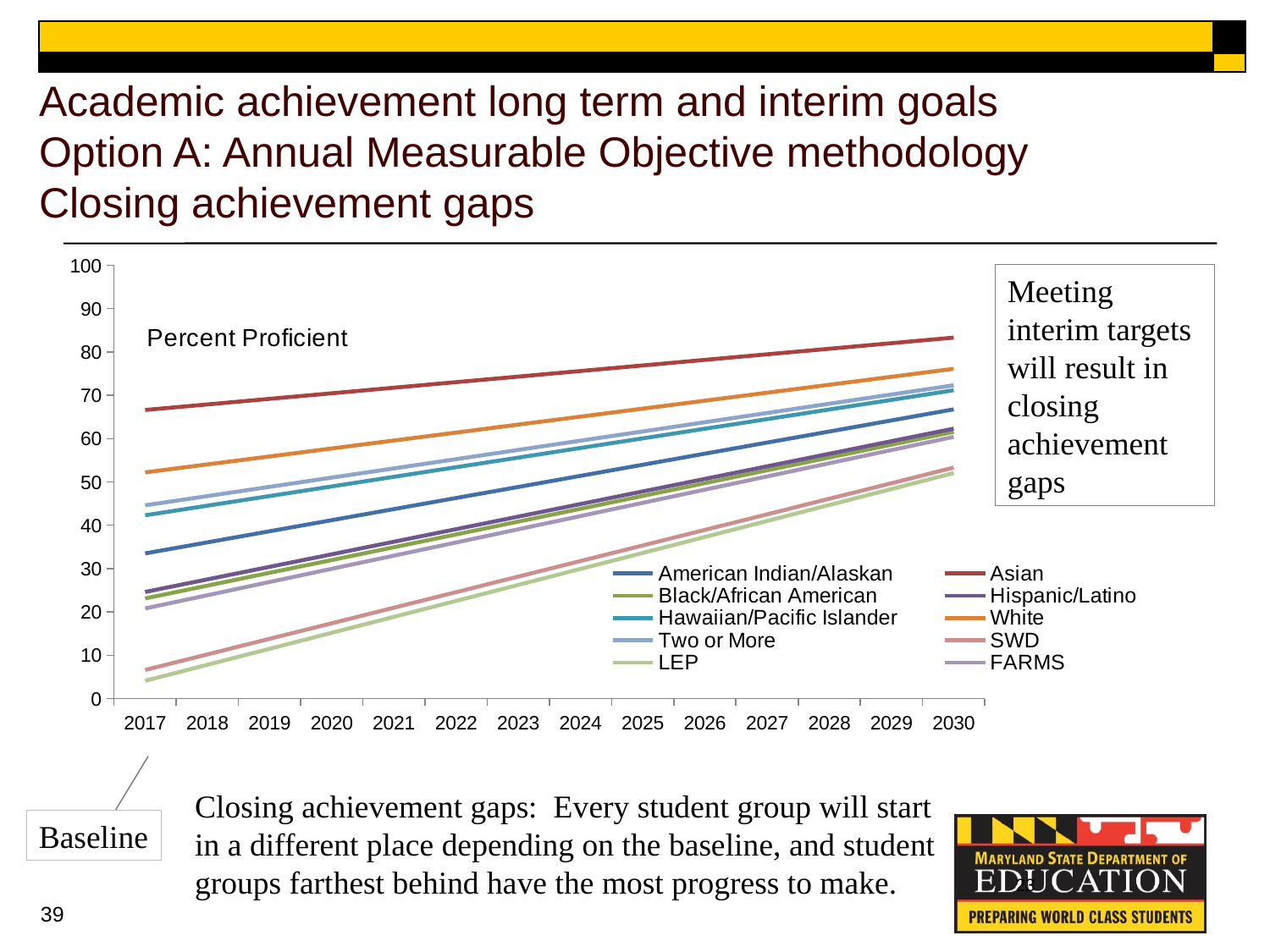
Is the value for Asian in 2017 greater or less than 60? greater In 2017, which is larger: the value for Asian or the value for White? Asian What label is printed inside the plot area near the top left of the chart? Percent Proficient Is the value for LEP in 2017 greater or less than 10? less Is the value for White in 2030 greater or less than 70? greater Which student group has the highest percent proficient in 2017? Asian How many years are shown along the x axis? 14 What kind of chart is shown on the slide? line chart Which student group has the lowest percent proficient in 2017? LEP How many student groups (series) does the legend list? 10 Do the lines for the student groups rise or fall from 2017 to 2030? rise